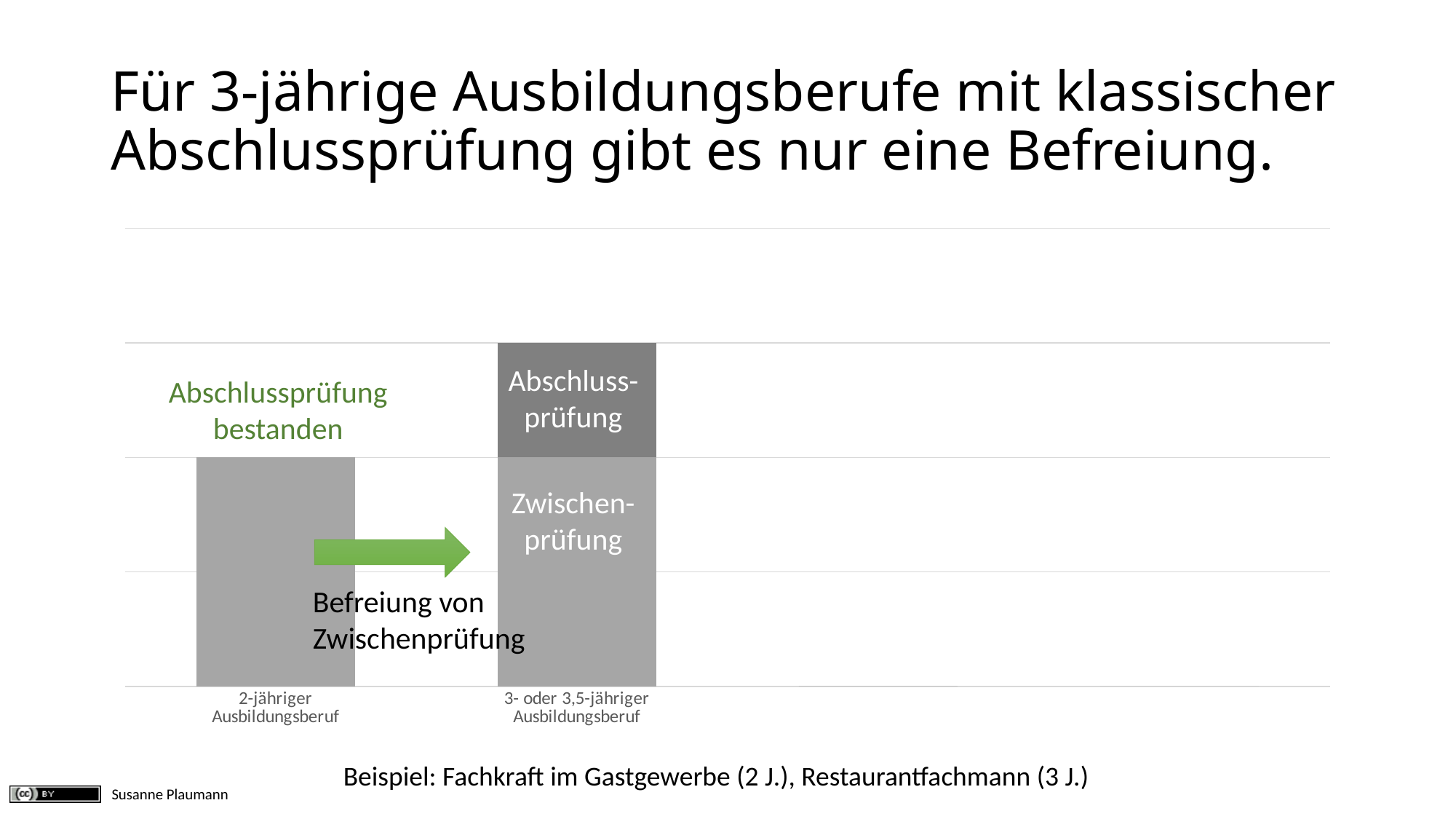
How many segments make up the bar for 3- oder 3,5-jähriger Ausbildungsberuf? 2 How many categories are shown on the x axis of the chart? 2 Which category has the shortest bar in the chart? 2-jähriger Ausbildungsberuf Which segment sits on top of the stacked bar for 3- oder 3,5-jähriger Ausbildungsberuf? Abschlussprüfung Which category has the taller bar, 2-jähriger Ausbildungsberuf or 3- oder 3,5-jähriger Ausbildungsberuf? 3- oder 3,5-jähriger Ausbildungsberuf What text is written next to the green arrow between the two bars? Befreiung von Zwischenprüfung What kind of chart is shown on the slide? bar chart